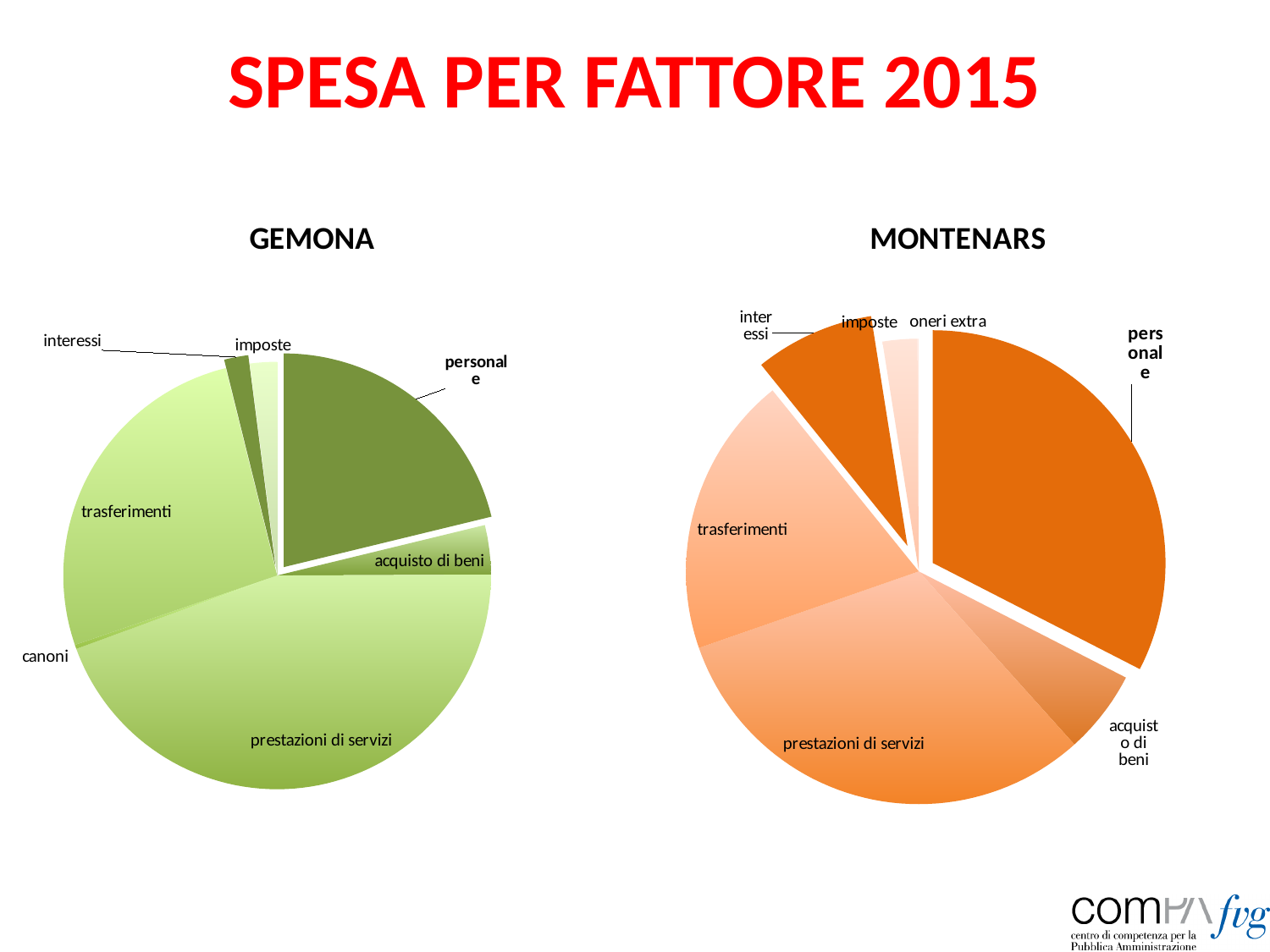
In the MONTENARS chart, how many slices does the pie have? 7 In the GEMONA chart, which slice is larger: trasferimenti or acquisto di beni? trasferimenti What is the title of the slide containing the two pie charts? SPESA PER FATTORE 2015 In the GEMONA chart, which slice is larger: personale or canoni? personale In the GEMONA chart, how many slices does the pie have? 7 What type of chart is used for GEMONA? pie chart What type of chart is used for MONTENARS? pie chart Which category appears in the MONTENARS chart but not in the GEMONA chart? oneri extra In the GEMONA chart, which category has the largest slice? prestazioni di servizi In the MONTENARS chart, which slice is larger: trasferimenti or interessi? trasferimenti